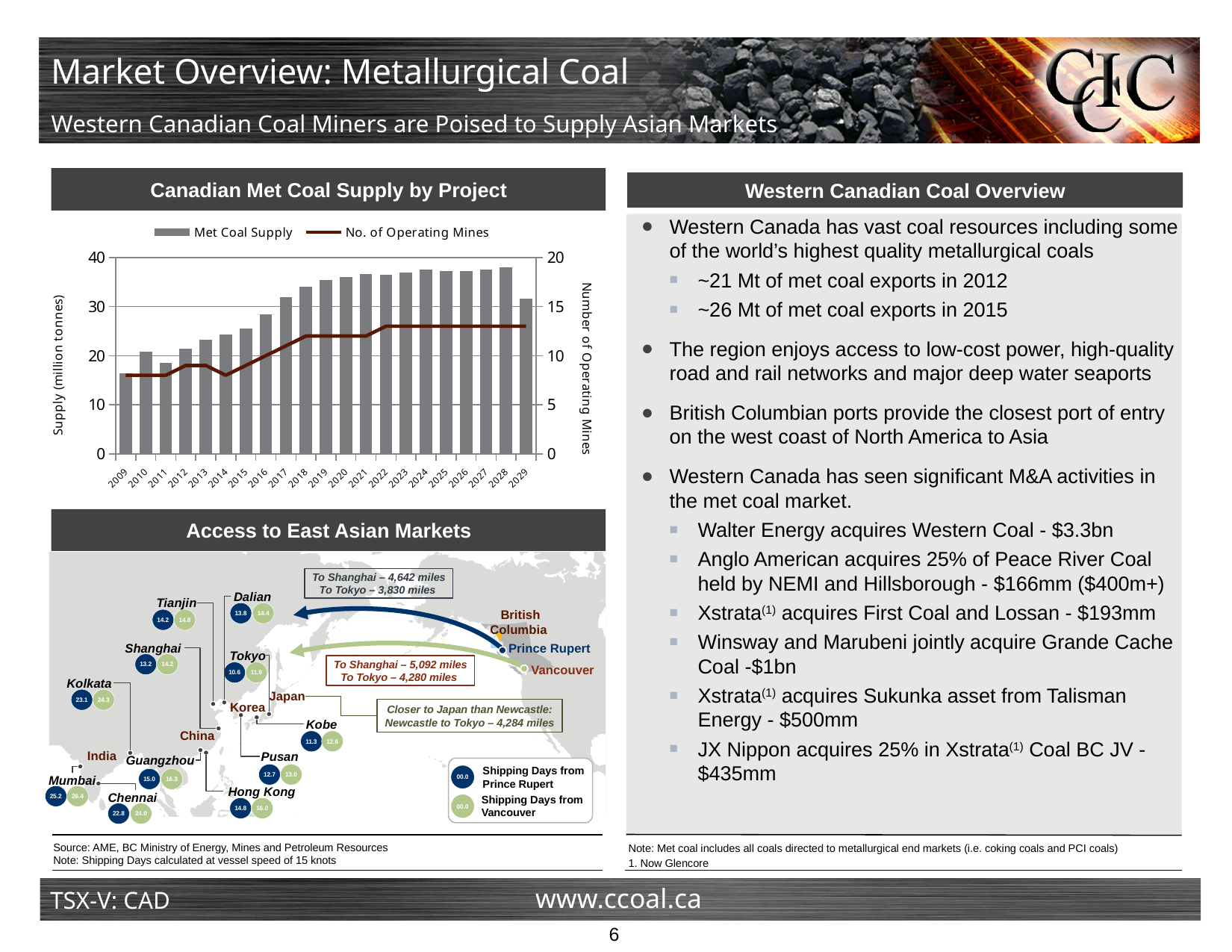
In the 'Canadian Met Coal Supply by Project' chart, which year has the larger Met Coal Supply, 2028 or 2029? 2028 How many years are shown on the x axis of the 'Canadian Met Coal Supply by Project' chart? 21 How many series does the legend of the 'Canadian Met Coal Supply by Project' chart list? 2 In the 'Canadian Met Coal Supply by Project' chart, is the No. of Operating Mines in 2025 greater or less than 10? greater In the 'Canadian Met Coal Supply by Project' chart, which year has the larger Met Coal Supply, 2010 or 2011? 2010 In the 'Canadian Met Coal Supply by Project' chart, is the Met Coal Supply value for 2009 greater or less than 20? less What kind of chart is 'Canadian Met Coal Supply by Project'? A bar chart with a line overlay In the 'Canadian Met Coal Supply by Project' chart, is the Met Coal Supply value for 2028 greater or less than 30? greater What is the title of the left vertical axis in the 'Canadian Met Coal Supply by Project' chart? Supply (million tonnes) In the 'Canadian Met Coal Supply by Project' chart, which year has the lowest Met Coal Supply? 2009 In the 'Canadian Met Coal Supply by Project' chart, do the Met Coal Supply bars generally rise or fall from 2009 to 2020? Rise